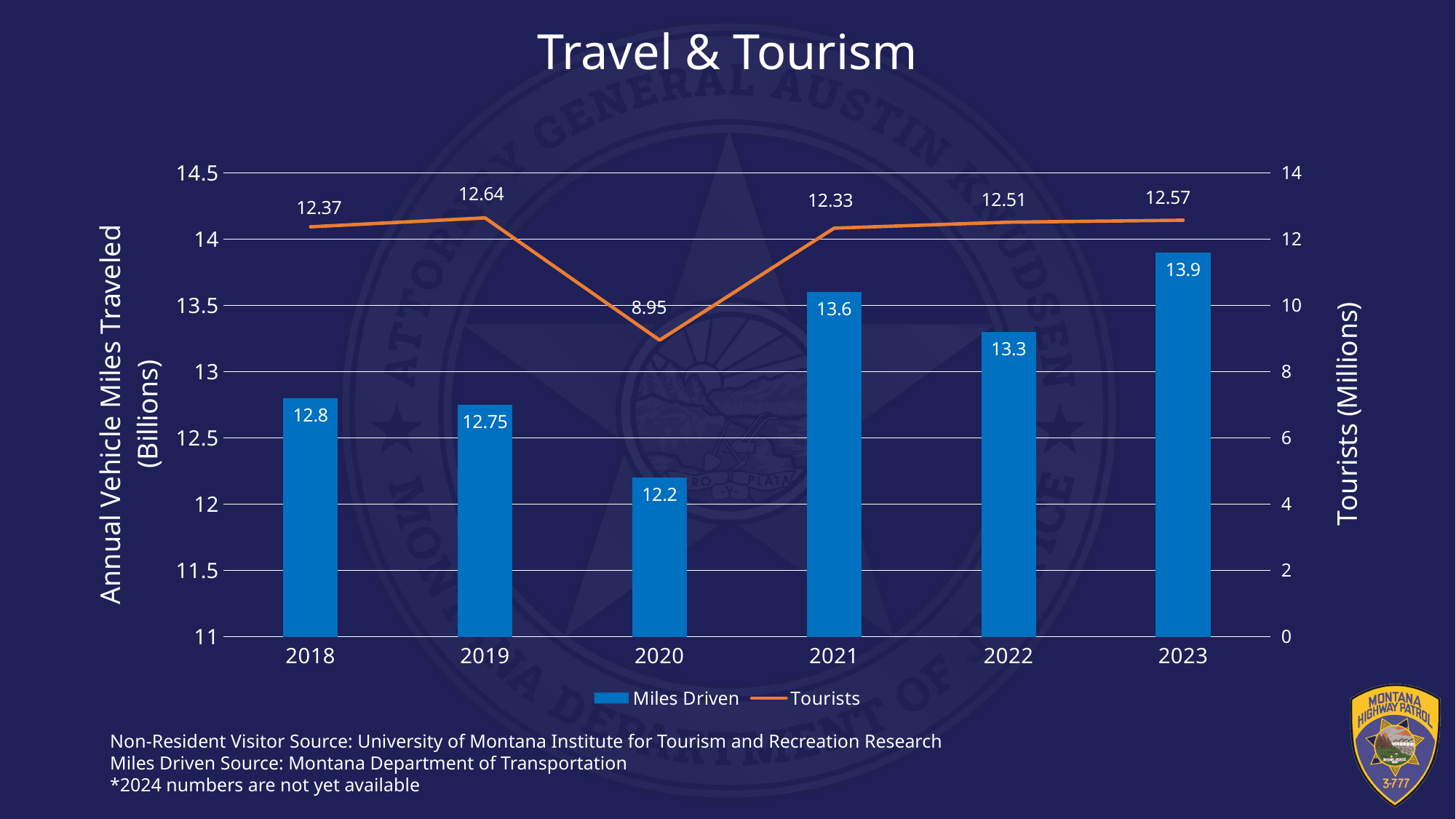
Which is larger, the Miles Driven value for 2018 or for 2019? 2018 What is the difference between the Miles Driven values for 2023 and 2022? 0.6 What is the difference between the Tourists values for 2019 and 2020? 3.69 Which year has the lowest Tourists value? 2020 Which year has the highest Miles Driven value? 2023 What is the Tourists value for 2023? 12.57 What is the Miles Driven value for 2020? 12.2 What kind of chart is used for the Miles Driven series? Bar chart What is the title of the chart? Travel & Tourism What is the Tourists value for 2019? 12.64 How many years are shown on the x axis? 6 How many series does the legend list? 2